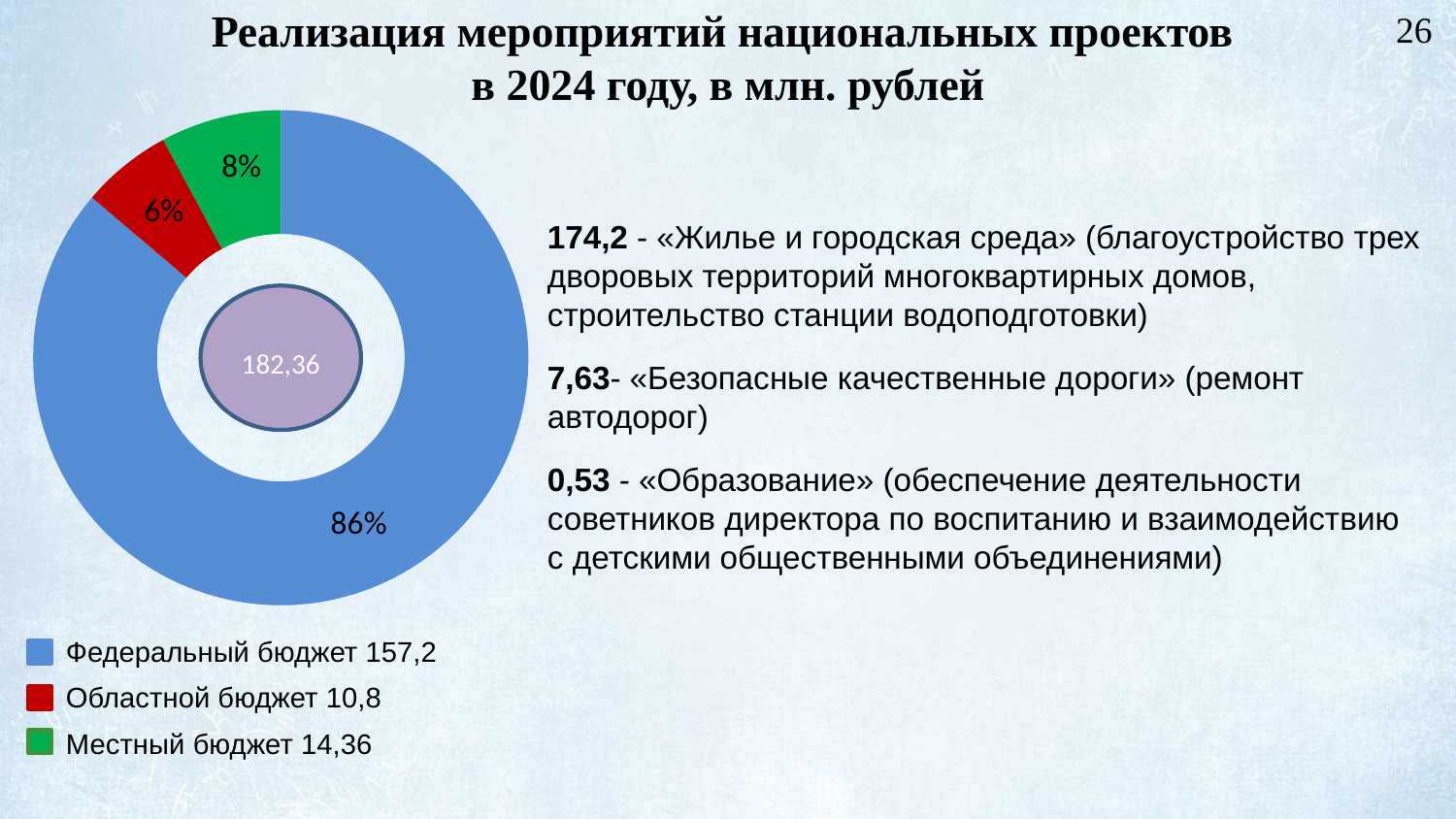
What percentage share does the Федеральный бюджет slice have? 86% What percentage share does the Местный бюджет slice have? 8% How many slices does the doughnut chart have? 3 Which is larger, the Местный бюджет value or the Областной бюджет value? Местный бюджет What value is shown in the legend for Местный бюджет? 14,36 What value is shown in the legend for Областной бюджет? 10,8 Which budget source has the smallest share of the doughnut chart? Областной бюджет What kind of chart is shown on the slide? doughnut (pie) chart What percentage share does the Областной бюджет slice have? 6% Which budget source has the largest share of the doughnut chart? Федеральный бюджет What value is shown in the legend for Федеральный бюджет? 157,2 What total value is shown in the centre of the doughnut chart? 182,36